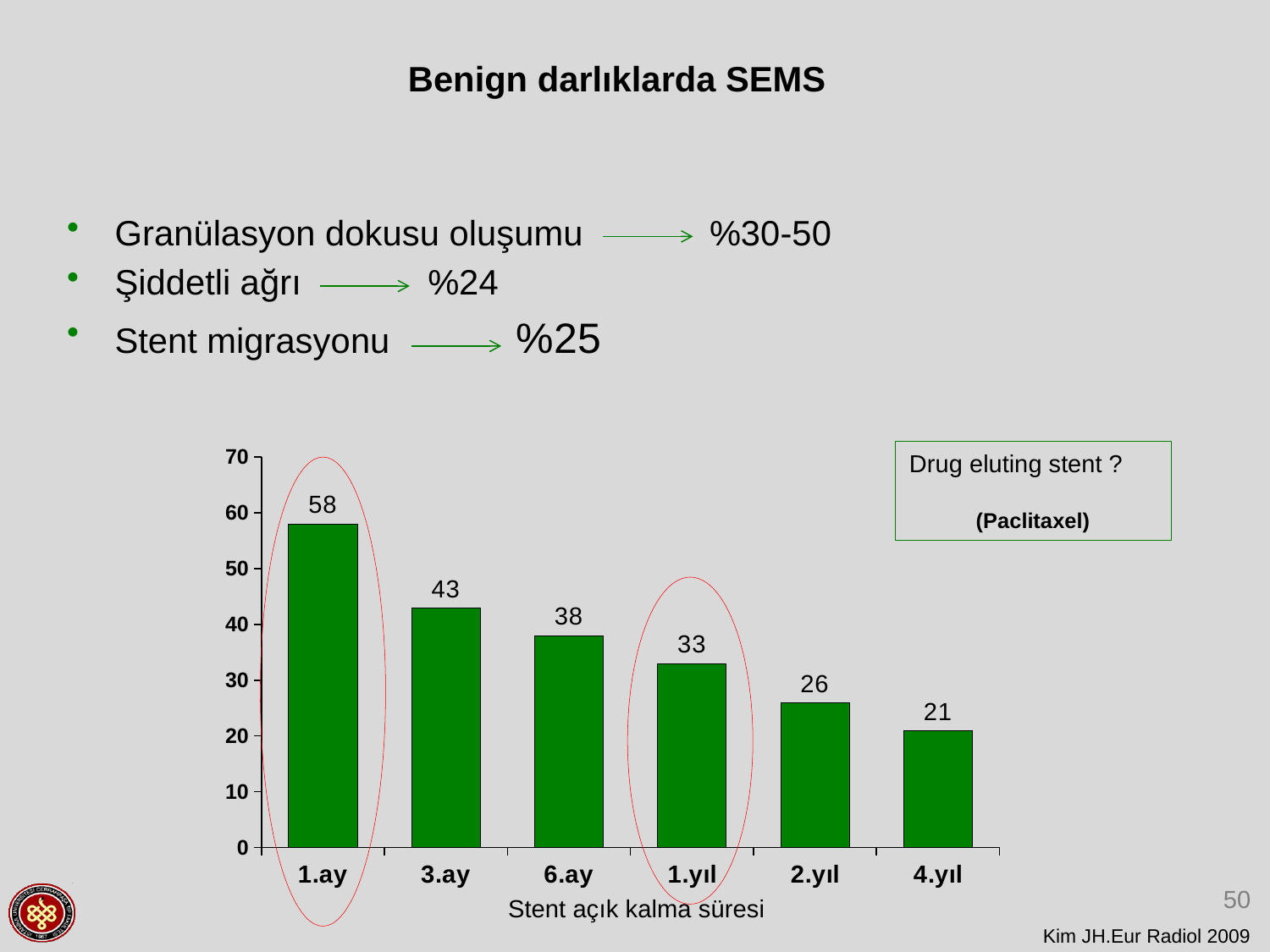
How many categories are shown on the x axis of the chart? 6 What is the value for 6.ay in the chart? 38 Which is larger, the value for 3.ay or the value for 2.yıl? 3.ay Which category has the lowest value in the chart? 4.yıl What is the difference between the values for 3.ay and 4.yıl? 22 What is the difference between the values for 1.ay and 1.yıl? 25 What is the value for 2.yıl in the chart? 26 What is the value for 1.ay in the chart? 58 What kind of chart is shown on the slide? bar chart Which category has the highest value in the chart? 1.ay Do the values rise or fall from 1.ay to 4.yıl along the x axis? fall What is the x-axis title of the chart? Stent açık kalma süresi